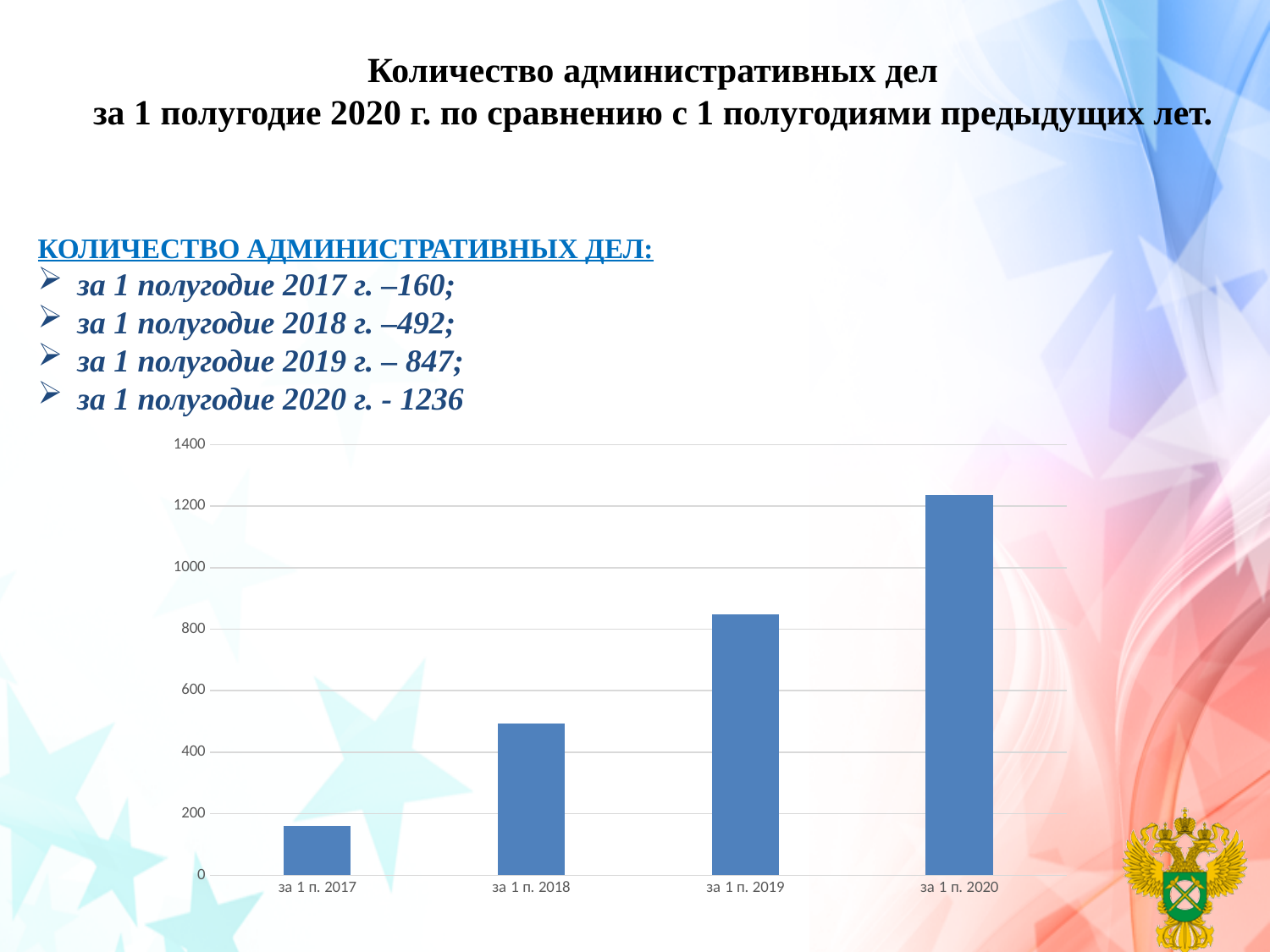
Is the value for за 1 п. 2020 greater or less than 1200? greater Which category has the highest value in the chart? за 1 п. 2020 Is the value for за 1 п. 2018 greater or less than 600? less Do the values rise or fall from за 1 п. 2017 to за 1 п. 2020? rise How many categories (bars) does the chart show? 4 Which is larger, the value for за 1 п. 2018 or the value for за 1 п. 2019? за 1 п. 2019 Is the value for за 1 п. 2019 greater or less than 800? greater According to the slide, how many administrative cases were there in the first half of 2020? 1236 According to the slide, how many administrative cases were there in the first half of 2017? 160 Which category has the lowest value in the chart? за 1 п. 2017 What kind of chart is shown on the slide? bar chart What is the highest value shown on the chart's vertical axis? 1400